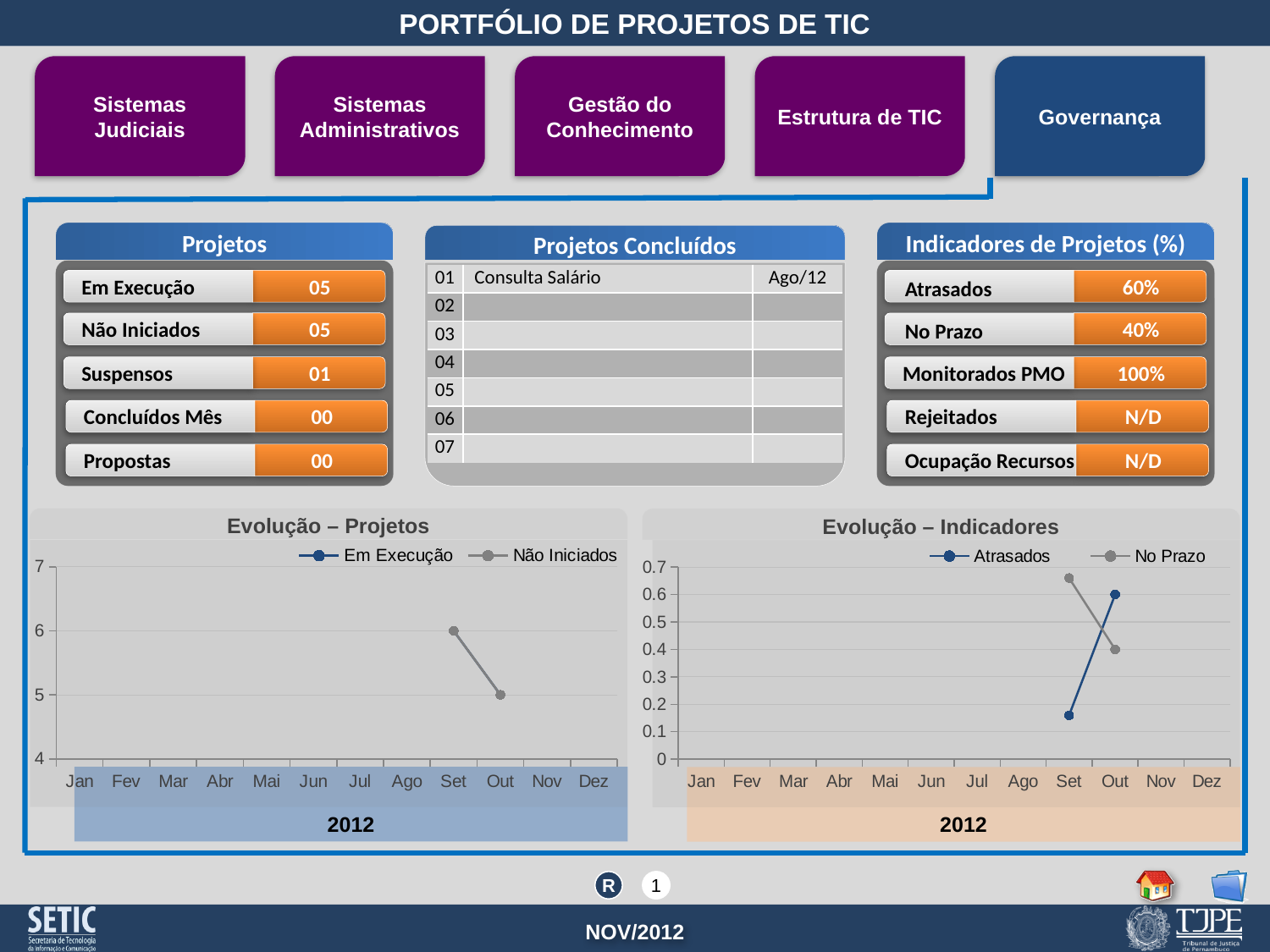
In the "Evolução – Indicadores" chart, which series has the higher value in Out, Atrasados or No Prazo? Atrasados In the "Evolução – Projetos" chart, what is the value for Não Iniciados in Out? 5 How many series does the legend of the "Evolução – Indicadores" chart list? 2 In the "Evolução – Indicadores" chart, does the Atrasados line rise or fall from Set to Out? rise In the "Evolução – Indicadores" chart, what is the value for Atrasados in Out? 0.6 How many months are shown on the x axis of the "Evolução – Projetos" chart? 12 In the "Evolução – Indicadores" chart, is the value for Atrasados in Set greater or less than 0.2? less In the "Evolução – Indicadores" chart, what is the value for No Prazo in Out? 0.4 What kind of chart is the "Evolução – Projetos" chart? line chart In the "Evolução – Indicadores" chart, is the value for No Prazo in Set greater or less than 0.6? greater In the "Evolução – Projetos" chart, what is the value for Não Iniciados in Set? 6 In the "Evolução – Projetos" chart, does the Não Iniciados line rise or fall from Set to Out? fall